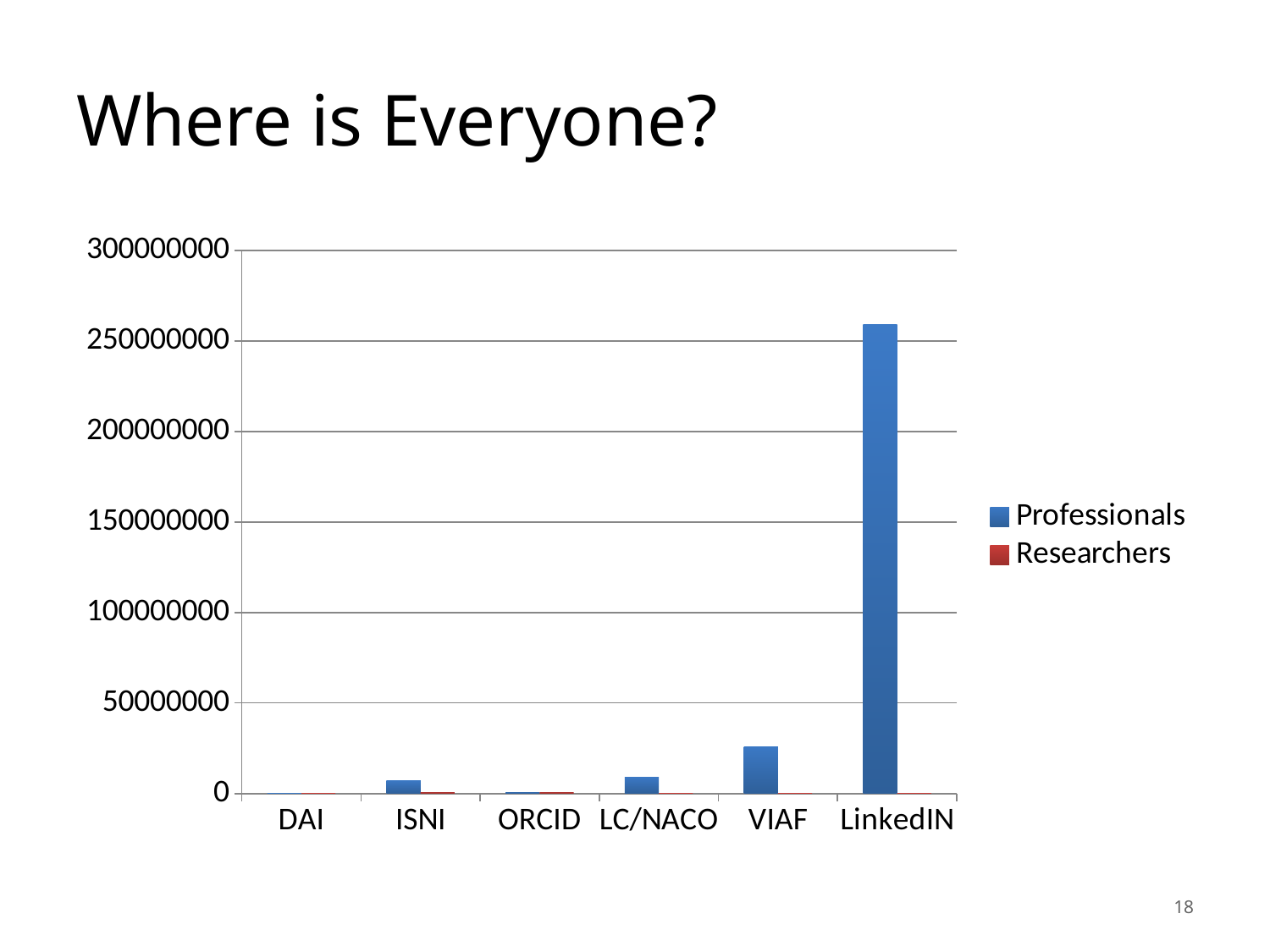
Is the Professionals value for LinkedIN greater or less than 250000000? greater How many categories are shown on the x axis? 6 Is the Professionals value for VIAF greater or less than 50000000? less What are the two series named in the legend? Professionals and Researchers Is the Professionals value for LC/NACO greater or less than 50000000? less Which has the larger Professionals value, ISNI or ORCID? ISNI Which category has the highest Professionals value? LinkedIN What kind of chart is shown on the slide? bar chart Which has the larger Professionals value, LinkedIN or VIAF? LinkedIN Which has the larger Professionals value, VIAF or LC/NACO? VIAF What is the title of the slide containing the chart? Where is Everyone? How many series does the legend list? 2